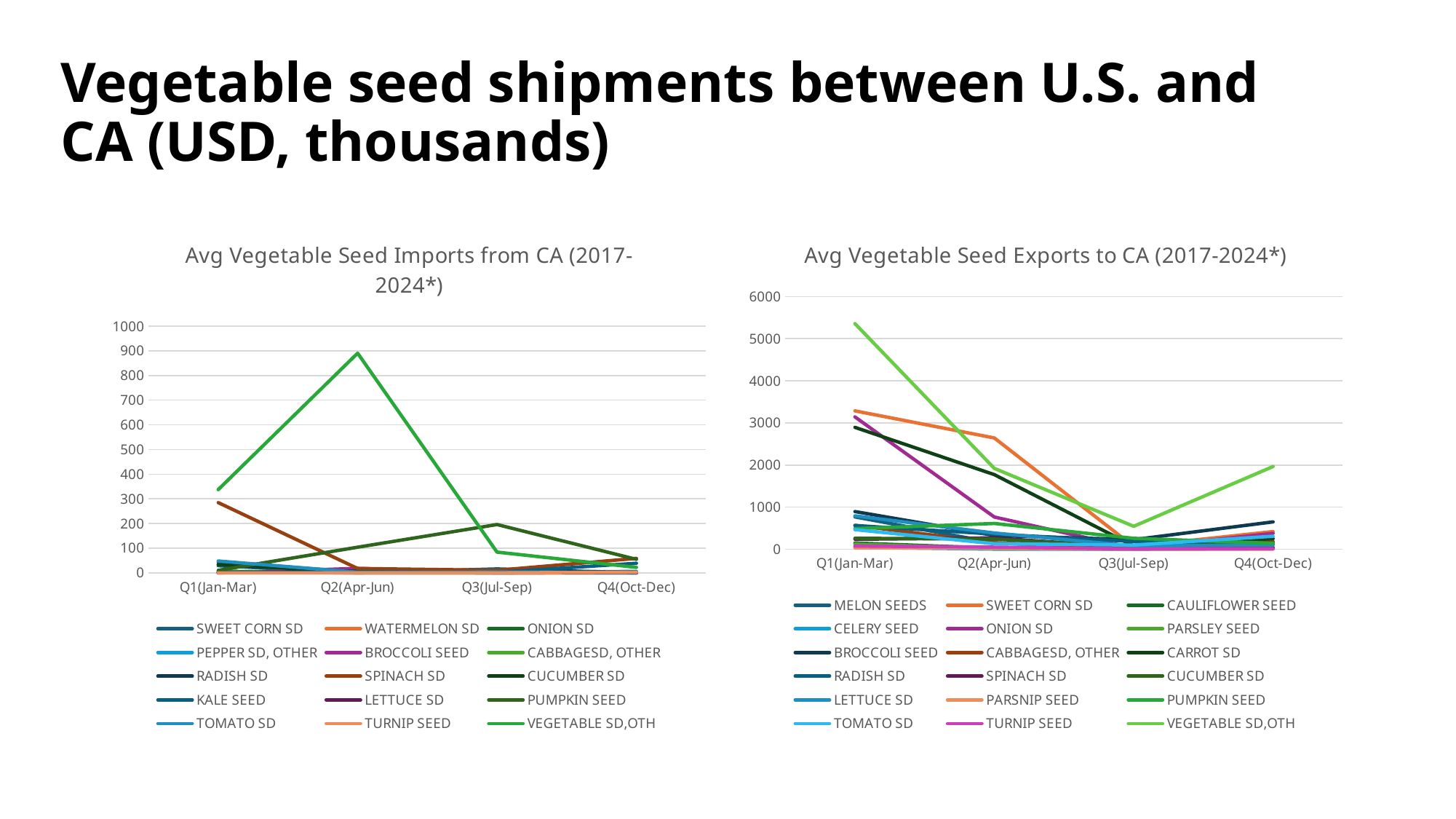
In the 'Avg Vegetable Seed Imports from CA (2017-2024*)' chart, is the value for SPINACH SD in Q1(Jan-Mar) greater or less than 200? greater In the 'Avg Vegetable Seed Exports to CA (2017-2024*)' chart, which is larger in Q1(Jan-Mar): VEGETABLE SD,OTH or SWEET CORN SD? VEGETABLE SD,OTH How many series does the legend of the 'Avg Vegetable Seed Exports to CA (2017-2024*)' chart list? 18 In the 'Avg Vegetable Seed Imports from CA (2017-2024*)' chart, in which quarter does VEGETABLE SD,OTH reach its highest value? Q2(Apr-Jun) In the 'Avg Vegetable Seed Exports to CA (2017-2024*)' chart, in which quarter does VEGETABLE SD,OTH reach its highest value? Q1(Jan-Mar) In the 'Avg Vegetable Seed Exports to CA (2017-2024*)' chart, is the value for SWEET CORN SD in Q1(Jan-Mar) greater or less than 3000? greater In the 'Avg Vegetable Seed Imports from CA (2017-2024*)' chart, is the value for VEGETABLE SD,OTH in Q2(Apr-Jun) greater or less than 800? greater How many quarters are shown on the x axis of the 'Avg Vegetable Seed Imports from CA (2017-2024*)' chart? 4 What is the title of the chart on the right side of the slide? Avg Vegetable Seed Exports to CA (2017-2024*) In the 'Avg Vegetable Seed Exports to CA (2017-2024*)' chart, does the SWEET CORN SD line rise or fall from Q1(Jan-Mar) to Q3(Jul-Sep)? fall What kind of chart is the 'Avg Vegetable Seed Imports from CA (2017-2024*)' chart? line chart